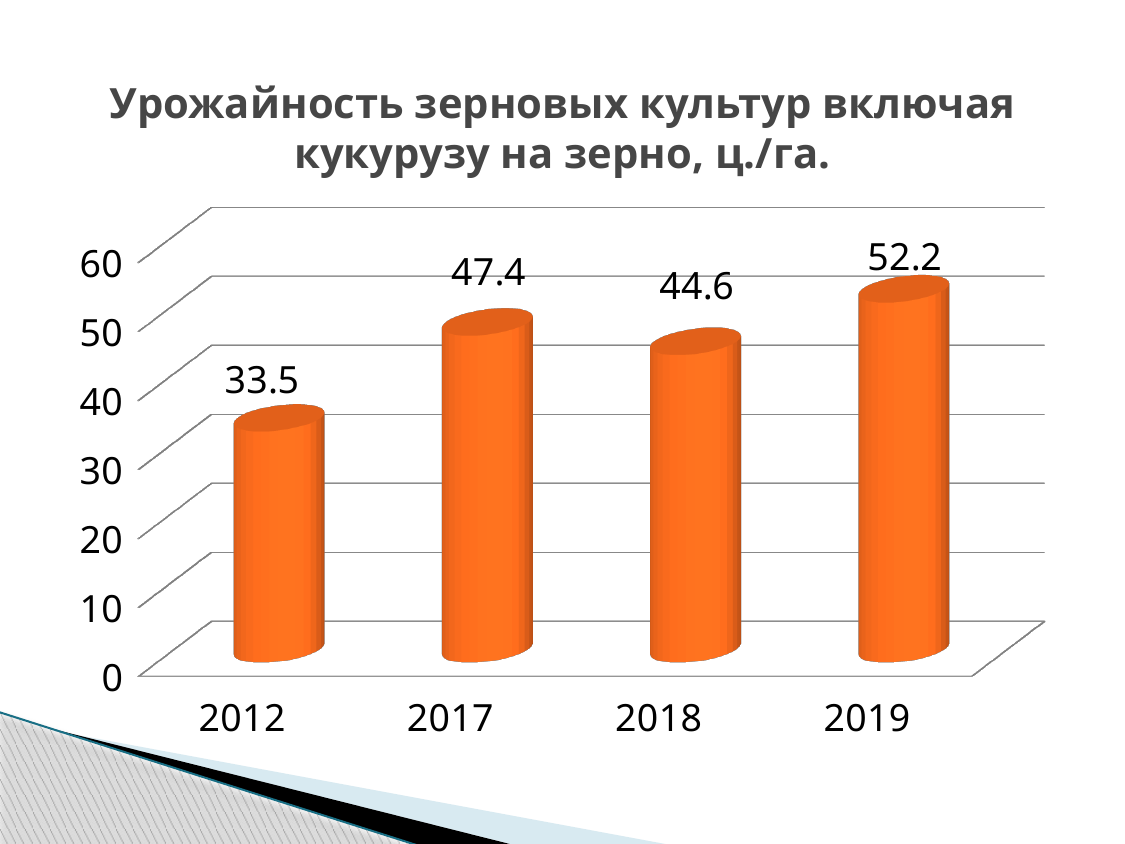
What is the value for 2012? 33.5 What is the value for 2019? 52.2 What is the title of the chart? Урожайность зерновых культур включая кукурузу на зерно, ц./га. What is the difference between the values for 2017 and 2018? 2.8 Which year has the highest value? 2019 How many years are shown on the chart? 4 What is the difference between the values for 2019 and 2012? 18.7 What is the value for 2017? 47.4 What is the value for 2018? 44.6 Which year has the lowest value? 2012 Which is larger, the value for 2017 or the value for 2018? 2017 What kind of chart is shown on the slide? bar chart